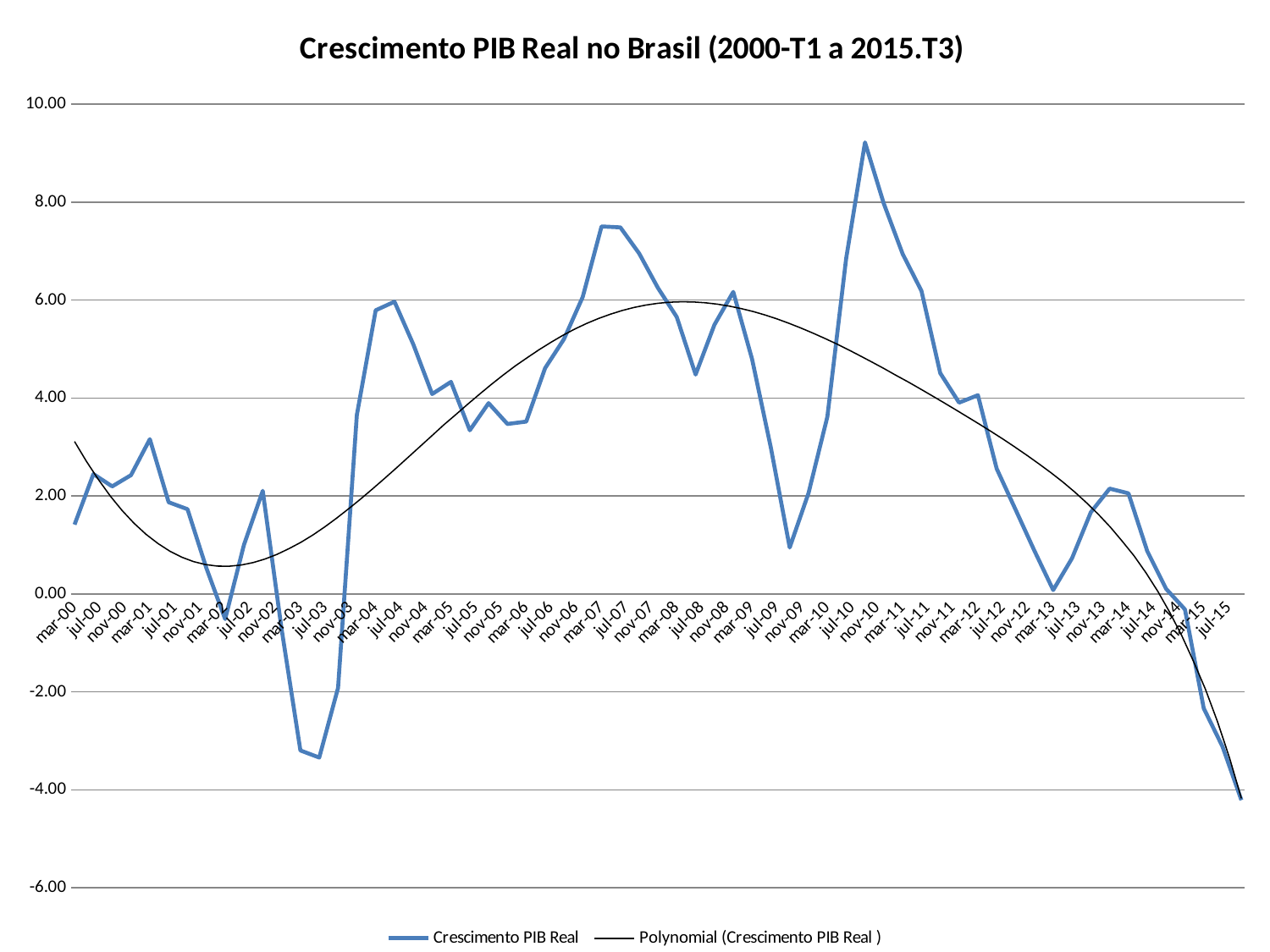
Is the value of Crescimento PIB Real at jul-03 greater or less than -2.00? less What is the highest value shown on the vertical axis? 10.00 Does the Crescimento PIB Real series rise or fall between mar-11 and jul-15? fall Is the value of Crescimento PIB Real at jul-07 greater or less than 6.00? greater Is the value of Crescimento PIB Real at nov-09 greater or less than 2.00? less What is the title of the chart? Crescimento PIB Real no Brasil (2000-T1 a 2015.T3) Around which labeled date does the Crescimento PIB Real series reach its highest value? nov-10 What is the name of the trendline entry in the legend? Polynomial (Crescimento PIB Real ) What kind of chart is shown on the slide? line chart How many entries does the legend list? 2 Which is larger, the Crescimento PIB Real value at nov-10 or at jul-07? nov-10